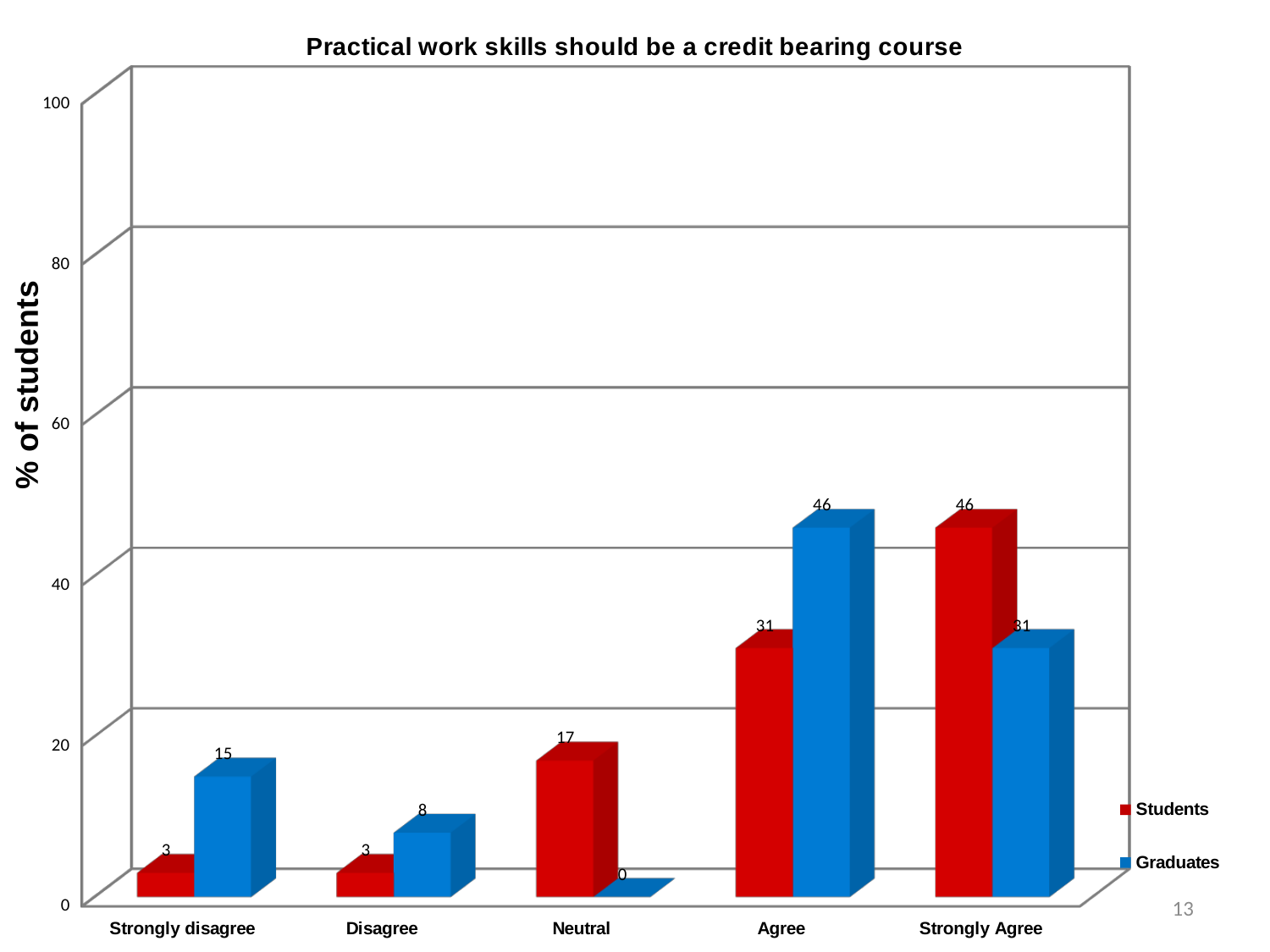
What is the value for Graduates in the Neutral category? 0 What kind of chart is shown on the slide? bar chart Which category has the highest value for Students? Strongly Agree What is the difference between the Graduates and Students values in the Agree category? 15 Which category has the lowest value for Graduates? Neutral What is the value for Graduates in the Strongly disagree category? 15 What is the title of the chart? Practical work skills should be a credit bearing course In the Strongly Agree category, which series has the larger value, Students or Graduates? Students What is the value for Students in the Agree category? 31 Is the value for Graduates in the Agree category greater or less than 40? greater How many series does the legend list? 2 How many categories are shown on the x axis? 5